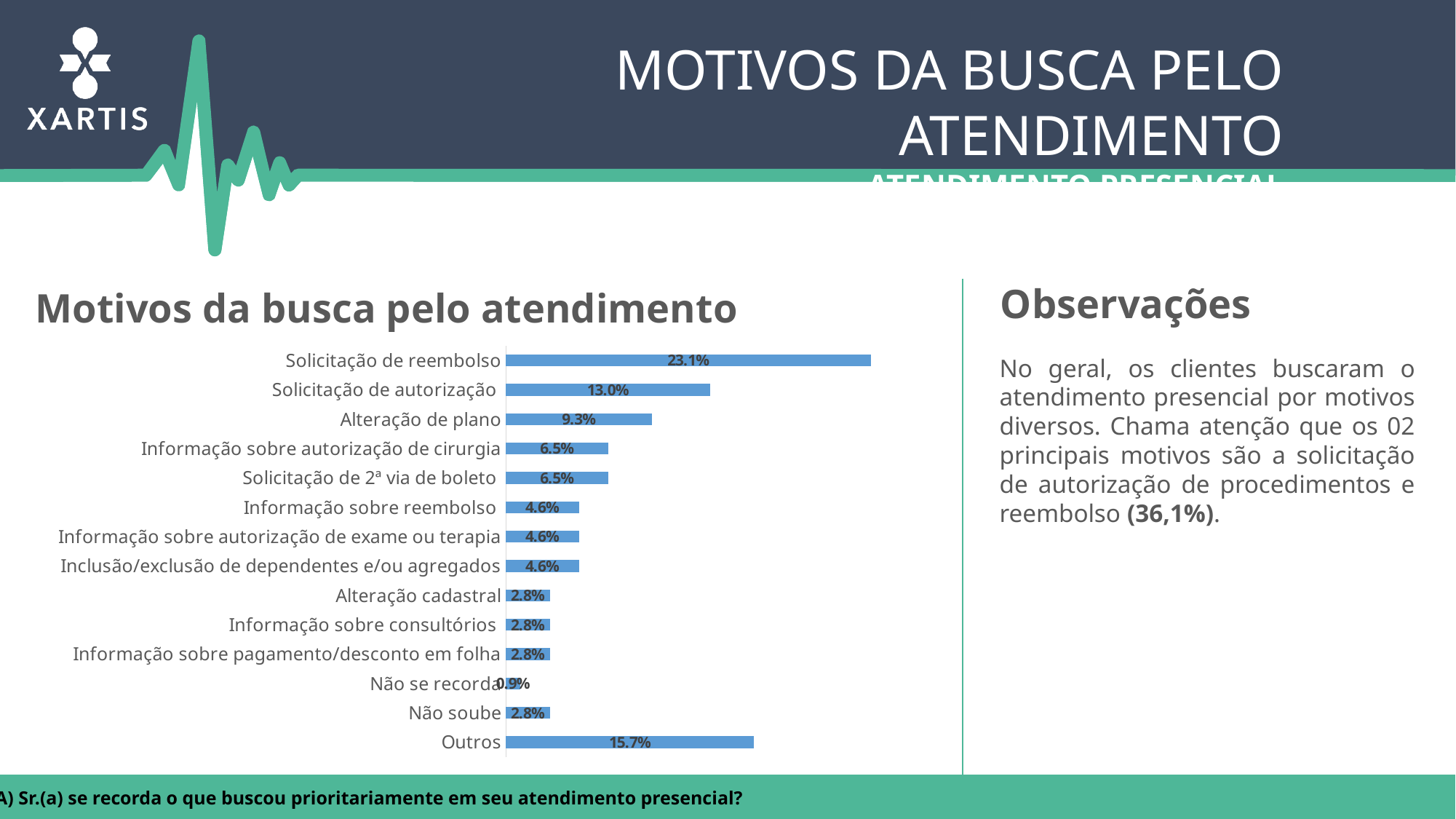
What is the value for "Não se recorda"? 0.9% What is the value for "Solicitação de reembolso"? 23.1% Which category has the highest value? Solicitação de reembolso Which category has the lowest value? Não se recorda What is the difference between "Solicitação de reembolso" and "Solicitação de autorização"? 10.1% What kind of chart is shown on the slide? Bar chart Which is larger: "Outros" or "Solicitação de autorização"? Outros What is the title of the chart? Motivos da busca pelo atendimento What is the value for "Informação sobre autorização de cirurgia"? 6.5% How many categories are shown in the chart? 14 What is the value for "Alteração de plano"? 9.3% What is the value for "Outros"? 15.7%